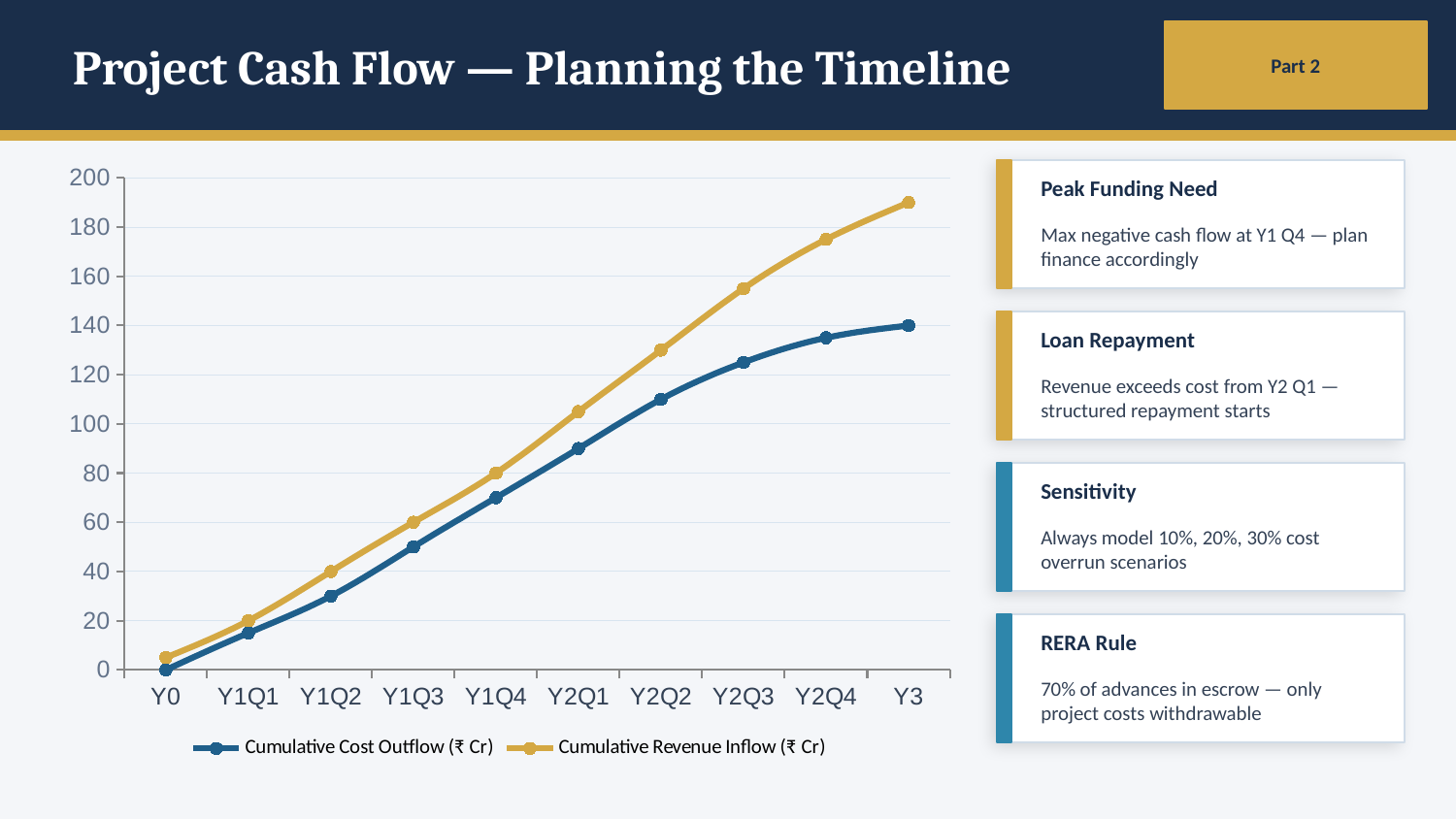
How many series does the legend list? 2 At which time point does Cumulative Revenue Inflow reach its highest value? Y3 At Y2Q3, which series has the higher value, Cumulative Cost Outflow or Cumulative Revenue Inflow? Cumulative Revenue Inflow Is the Cumulative Cost Outflow value at Y2Q1 greater or less than 100? less What is the Cumulative Cost Outflow (₹ Cr) value at Y3? 140 What is the Cumulative Cost Outflow (₹ Cr) value at Y0? 0 How many time points are plotted along the x axis? 10 What is the Cumulative Revenue Inflow (₹ Cr) value at Y1Q4? 80 Do the Cumulative Cost Outflow values rise or fall from Y0 to Y3? rise What kind of chart is shown on the slide? line chart Which series is drawn in the gold/yellow line? Cumulative Revenue Inflow (₹ Cr) Is the Cumulative Revenue Inflow value at Y3 greater or less than 180? greater